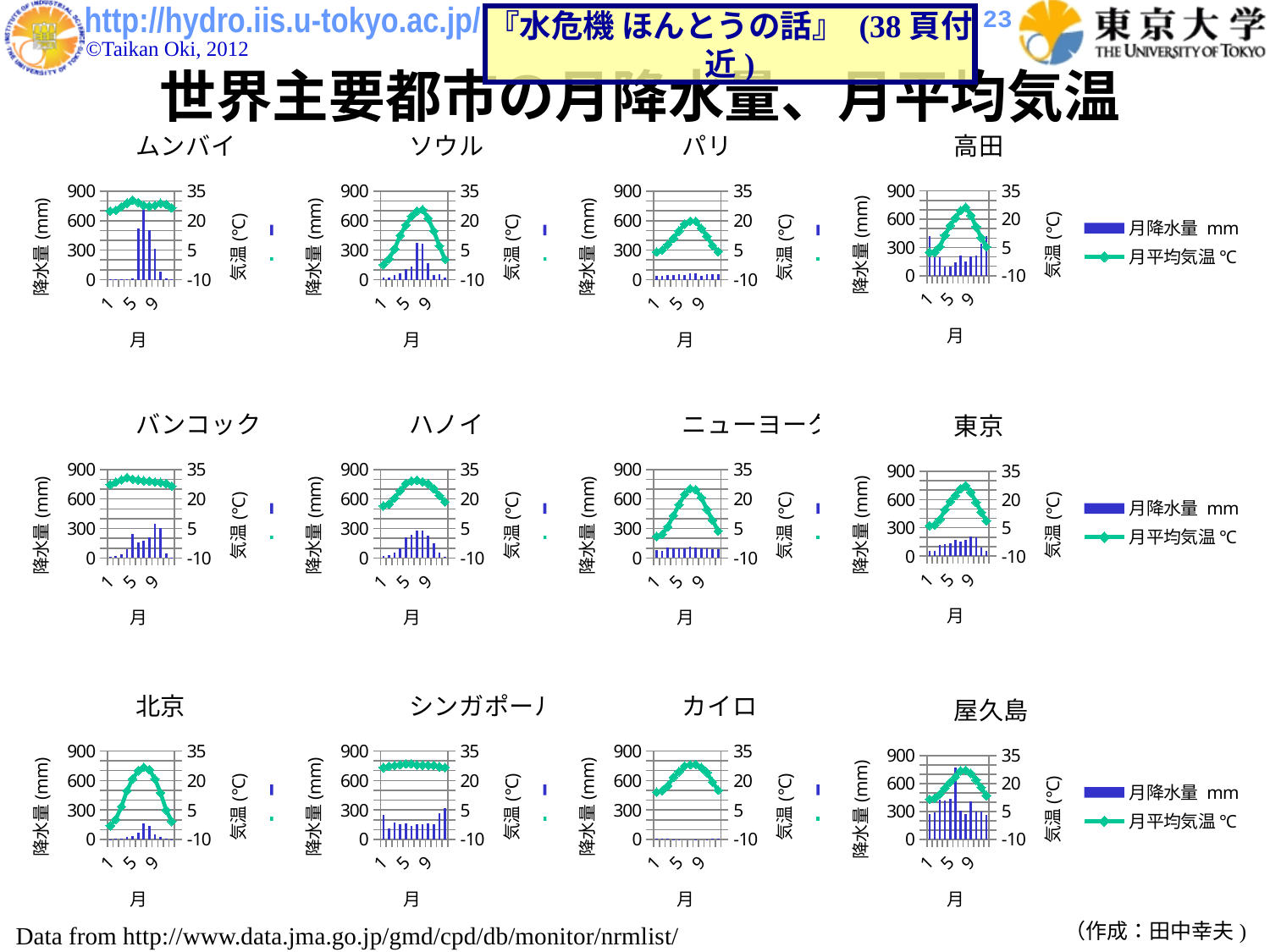
Which city has the higher peak monthly precipitation, ムンバイ or パリ? ムンバイ In the シンガポール chart, is the monthly mean temperature greater or less than 20 °C throughout the year? greater What are the two legend entries shown next to the charts? 月降水量 mm and 月平均気温 ℃ In the カイロ chart, is the monthly precipitation in every month greater or less than 300 mm? less Which city has the higher monthly mean temperature in month 1, バンコック or 北京? バンコック What kind of chart is used for each city (e.g. the ムンバイ chart)? Combined bar and line chart In the ソウル chart, does the monthly mean temperature rise or fall from month 8 to month 12? fall In the ムンバイ chart, is the tallest monthly precipitation bar greater or less than 600 mm? greater How many city charts are shown on the slide? 12 How many series does the legend list for each chart? 2 In the 北京 chart, does the monthly mean temperature rise or fall from month 1 to month 7? rise